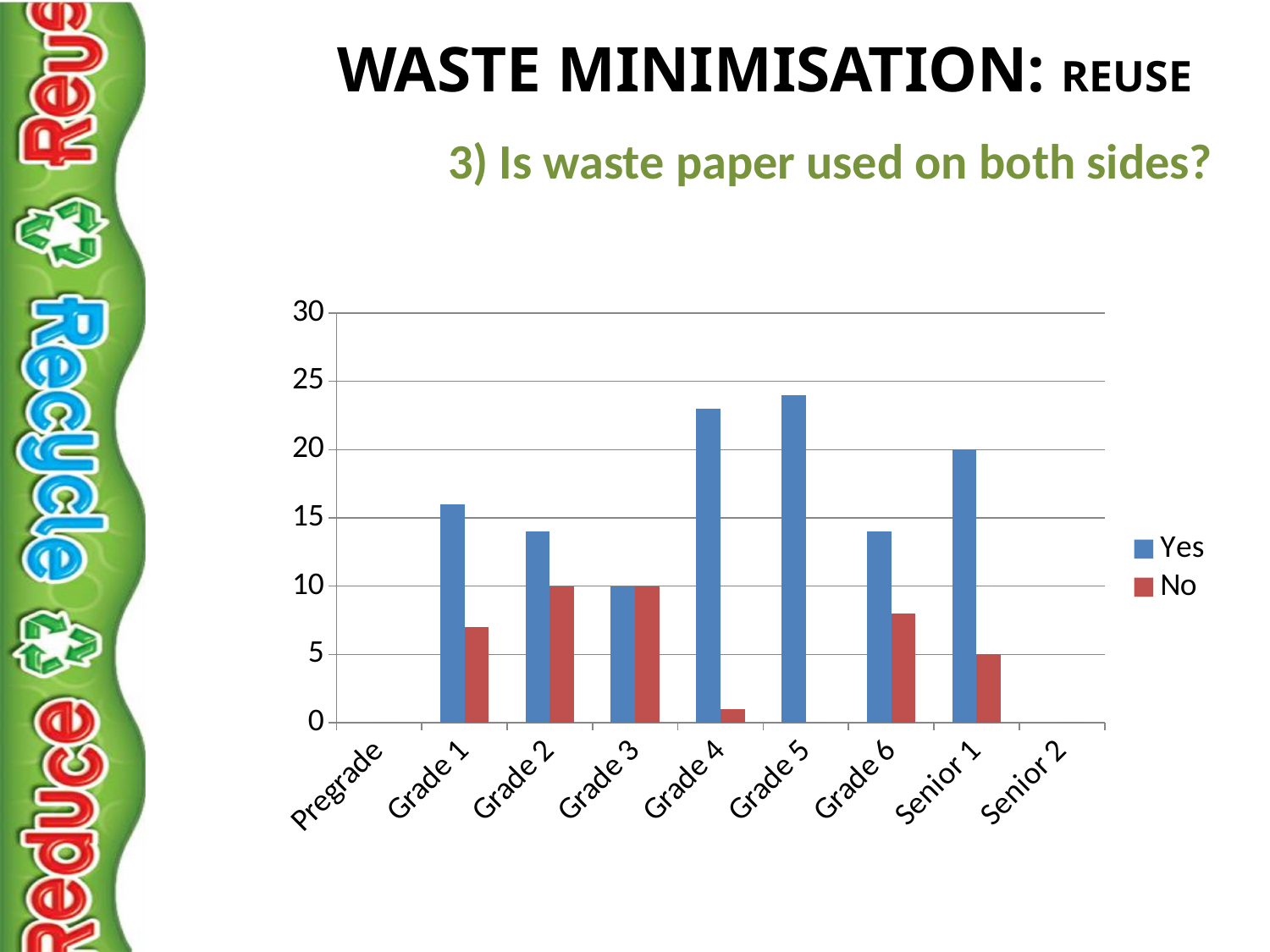
What is the difference between the Yes and No values for Senior 1? 15 Is the No value for Grade 6 greater or less than 10? less How many series does the legend list? 2 How many categories are shown on the x axis? 9 What kind of chart is shown on the slide? bar chart Is the Yes value for Grade 4 greater or less than 20? greater What are the two entries in the legend? Yes and No What is the No value for Grade 3? 10 For Grade 1, which is larger, the Yes value or the No value? Yes Which category has the lowest No value among those with a visible No bar? Grade 4 What is the Yes value for Senior 1? 20 What is the No value for Senior 1? 5